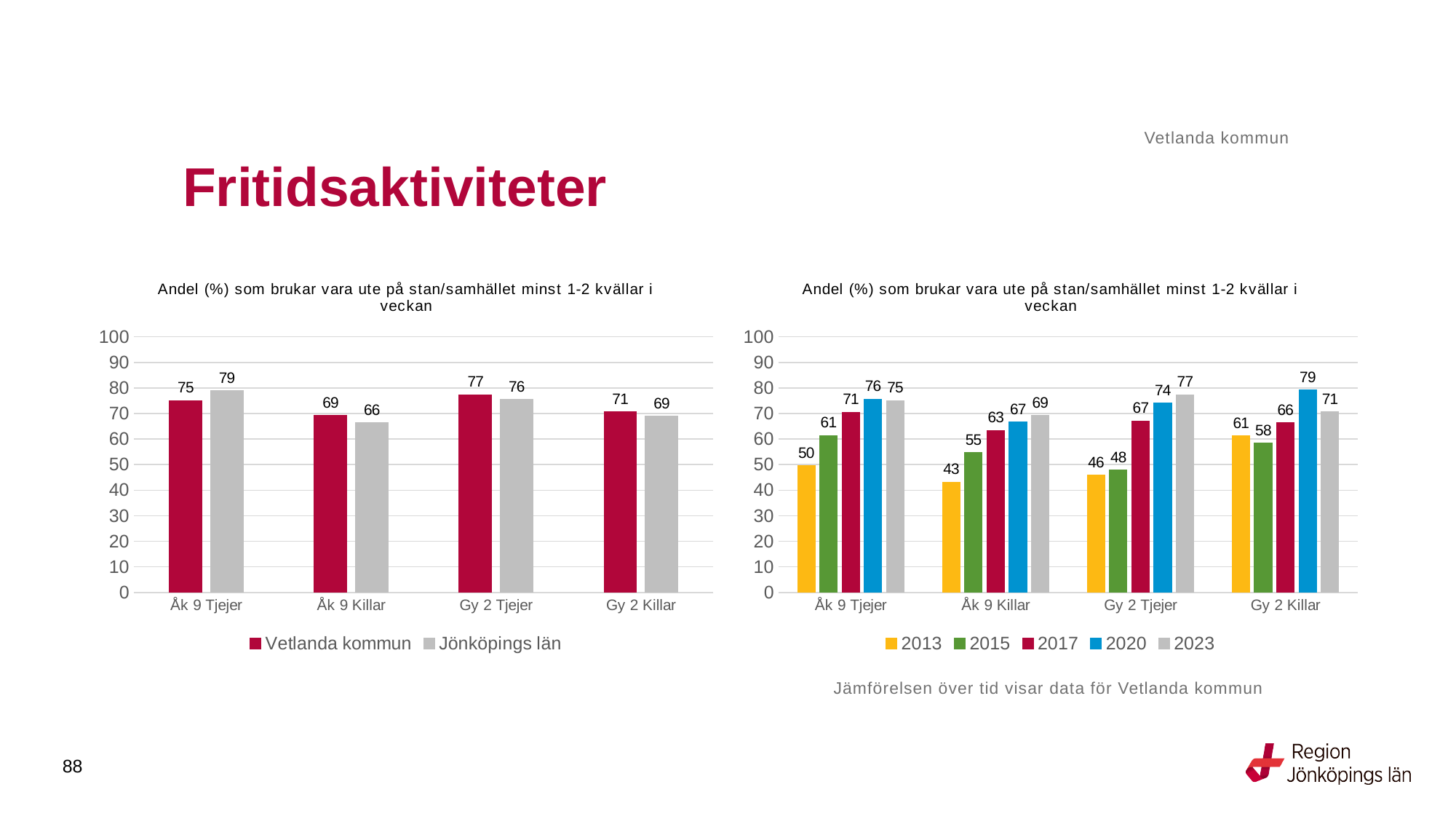
In the left chart, how many series does the legend list? 2 In the left chart, what is the value for Jönköpings län for Gy 2 Killar? 69 In the left chart, what is the value for Vetlanda kommun for Åk 9 Tjejer? 75 In the right chart, which year has the lowest value for Gy 2 Tjejer? 2013 In the right chart, what is the value for 2020 for Gy 2 Killar? 79 In the right chart, how many series does the legend list? 5 In the right chart, is the value for 2023 larger for Åk 9 Tjejer or for Gy 2 Killar? Åk 9 Tjejer In the right chart, what is the value for 2013 for Åk 9 Killar? 43 What kind of chart is the left chart? Bar chart In the left chart, what is the difference between Vetlanda kommun and Jönköpings län for Åk 9 Killar? 3 In the right chart, how many categories are shown on the x axis? 4 In the left chart, which category has the highest value for Vetlanda kommun? Gy 2 Tjejer